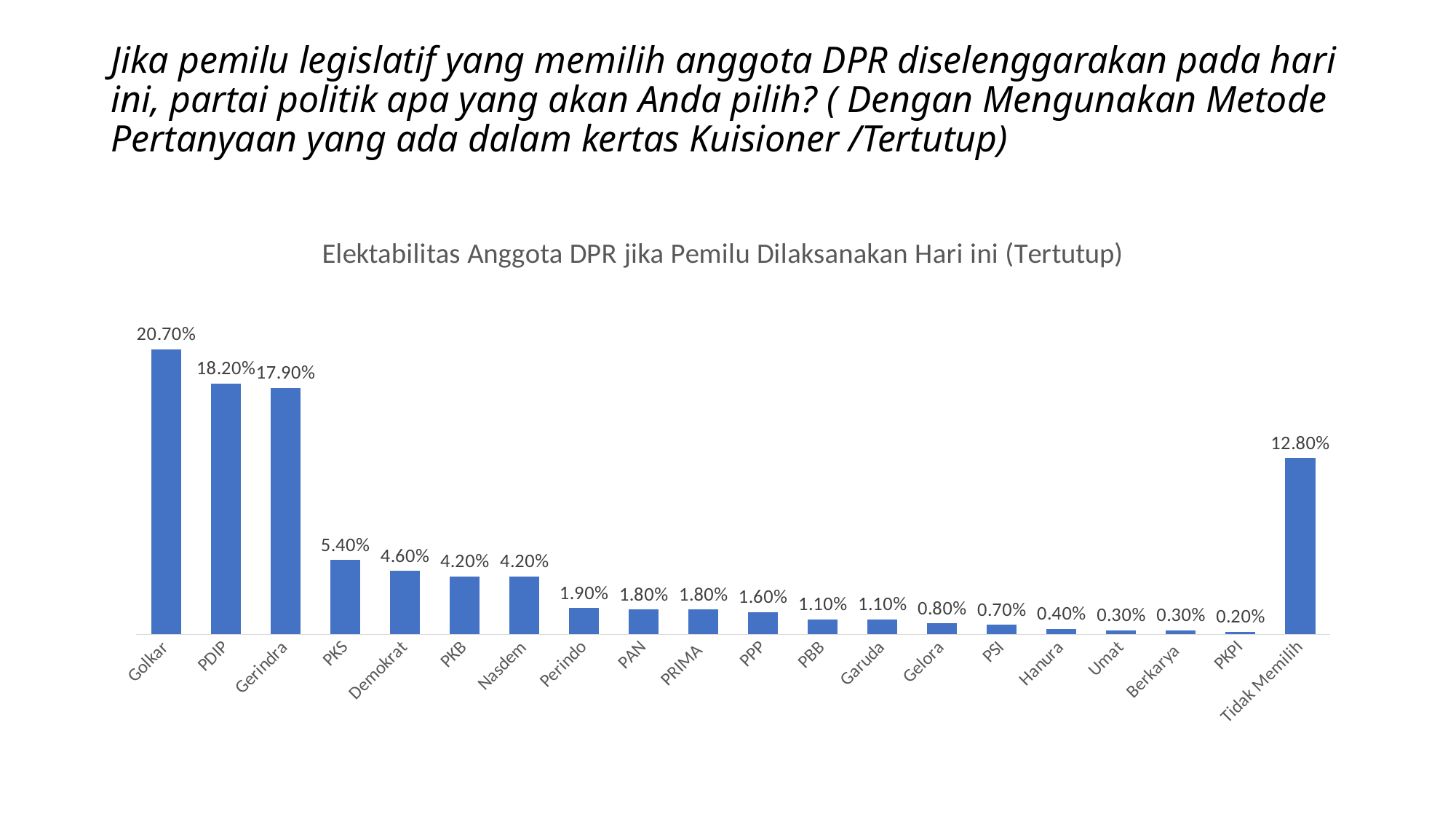
What is the value for PKS? 5.40% What is the value for Golkar? 20.70% Which is larger, the value for PDIP or the value for Gerindra? PDIP How many categories are shown on the x axis? 20 What is the value for Perindo? 1.90% What is the value for Tidak Memilih? 12.80% What is the title of the chart? Elektabilitas Anggota DPR jika Pemilu Dilaksanakan Hari ini (Tertutup) Which category has the highest value? Golkar What is the difference between the values for Golkar and PDIP? 2.50% What kind of chart is this? Bar chart Which category has the lowest value? PKPI What is the difference between the values for Gerindra and Tidak Memilih? 5.10%